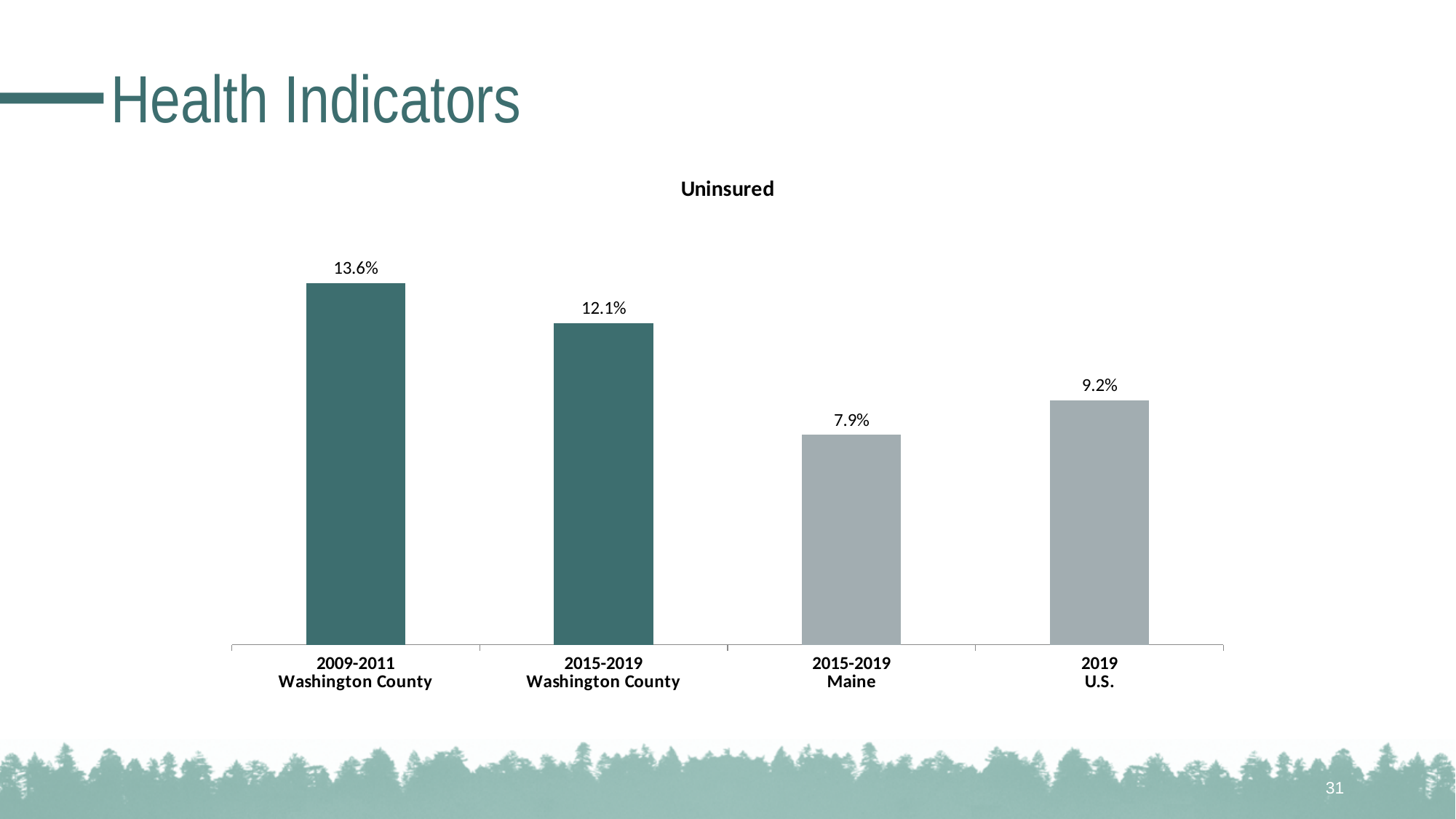
How many bars are shown in the chart? 4 Which category has the lowest uninsured rate? 2015-2019 Maine Which category has the highest uninsured rate? 2009-2011 Washington County What kind of chart is shown on the slide? Bar chart What is the uninsured rate for Washington County in 2009-2011? 13.6% What is the uninsured rate for Washington County in 2015-2019? 12.1% What is the uninsured rate for the U.S. in 2019? 9.2% What is the title of the chart? Uninsured Which is larger, the 2019 U.S. uninsured rate or the 2015-2019 Maine uninsured rate? 2019 U.S. What is the difference between the 2015-2019 Washington County uninsured rate and the 2015-2019 Maine rate? 4.2% What is the uninsured rate for Maine in 2015-2019? 7.9% What is the difference between the Washington County uninsured rate in 2009-2011 and in 2015-2019? 1.5%